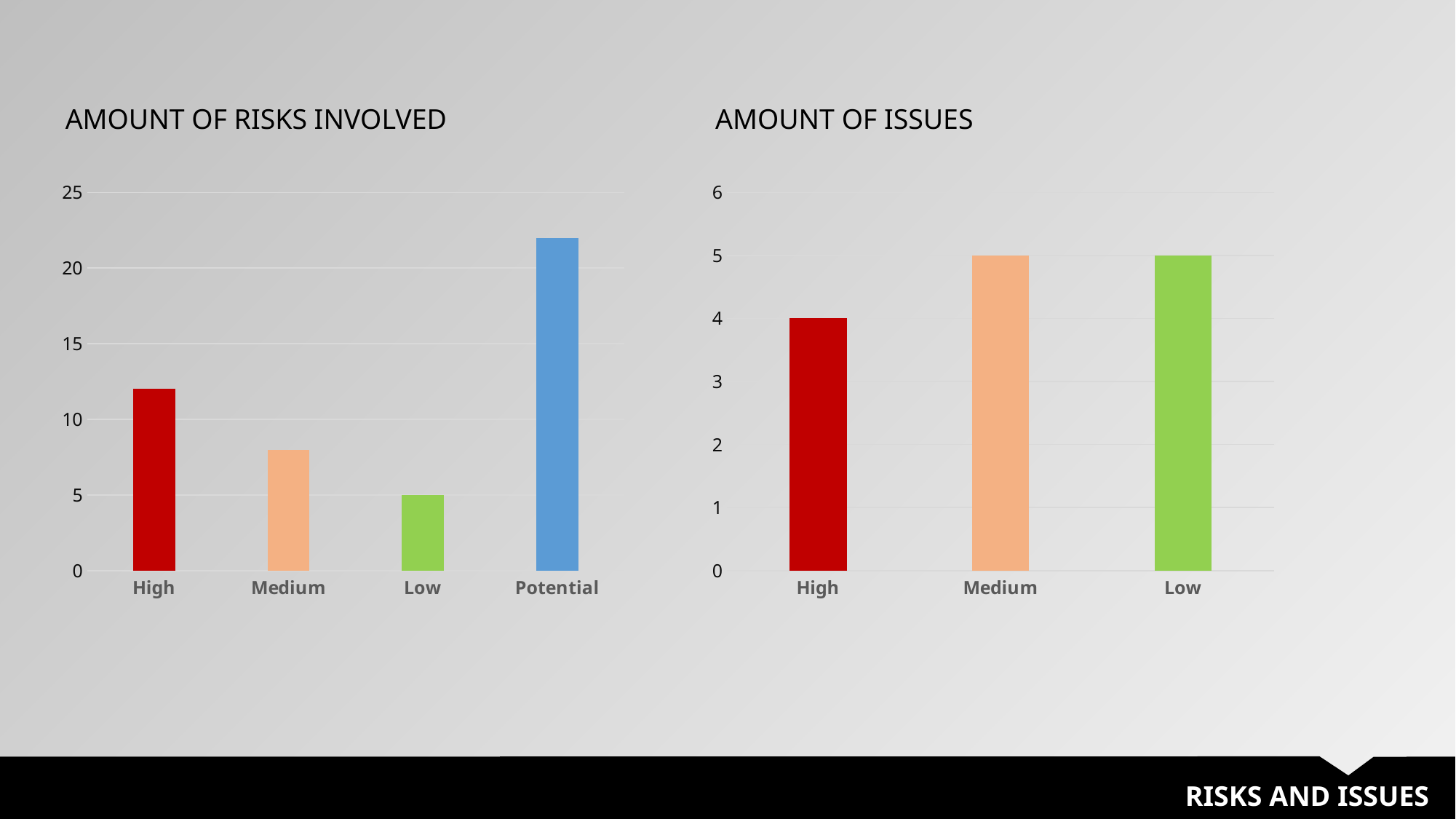
In the AMOUNT OF ISSUES chart, what is the difference between the values for Medium and High? 1 In the AMOUNT OF ISSUES chart, what is the value for High? 4 In the AMOUNT OF ISSUES chart, which category has the lowest value? High In the AMOUNT OF RISKS INVOLVED chart, is the value for High greater or less than 10? greater In the AMOUNT OF ISSUES chart, what is the value for Medium? 5 In the AMOUNT OF RISKS INVOLVED chart, which category has the highest value? Potential In the AMOUNT OF RISKS INVOLVED chart, how many categories are shown? 4 In the AMOUNT OF RISKS INVOLVED chart, what is the value for Low? 5 In the AMOUNT OF RISKS INVOLVED chart, is the value for Potential greater or less than 20? greater In the AMOUNT OF RISKS INVOLVED chart, which category has the lowest value? Low What kind of chart is the AMOUNT OF ISSUES chart? bar chart In the AMOUNT OF RISKS INVOLVED chart, is the value for Medium greater or less than 10? less